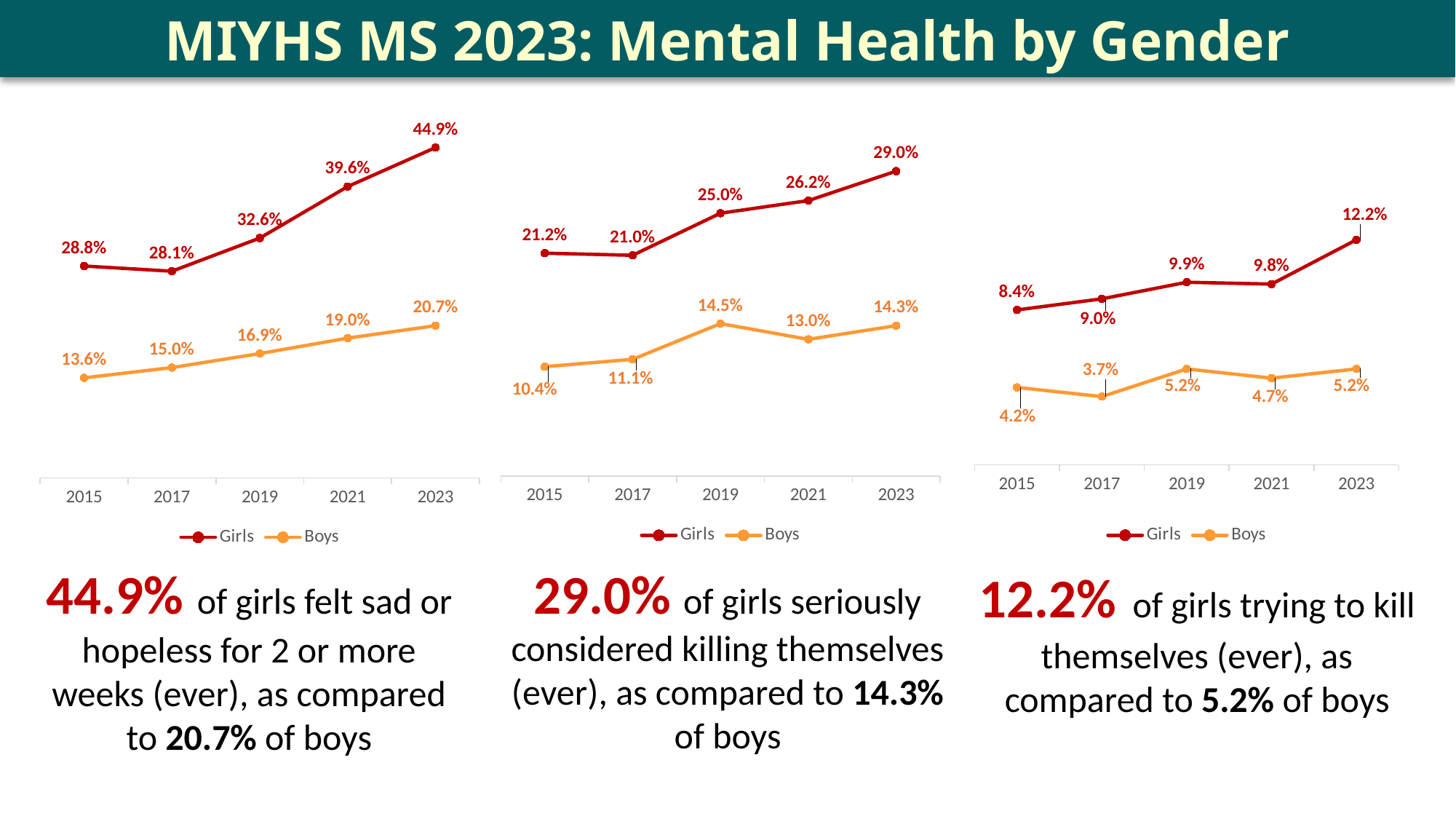
How many years are shown on the x axis of the right chart? 5 In the middle chart, which is larger in 2021: the Girls value or the Boys value? Girls In the middle chart, what is the value for Boys in 2019? 14.5% In the left chart, what is the difference between the Girls and Boys values in 2023? 24.2% What kind of chart is the left chart? Line chart In the right chart, in which year is the Boys value highest? 2019 and 2023 (both 5.2%) How many series does the legend of the middle chart list? 2 In the left chart, what is the value for Boys in 2015? 13.6% In the left chart, in which year is the Girls value lowest? 2017 In the left chart, what is the value for Girls in 2023? 44.9% In the middle chart, what is the difference between the Girls values in 2023 and 2015? 7.8% In the right chart, what is the value for Girls in 2017? 9.0%